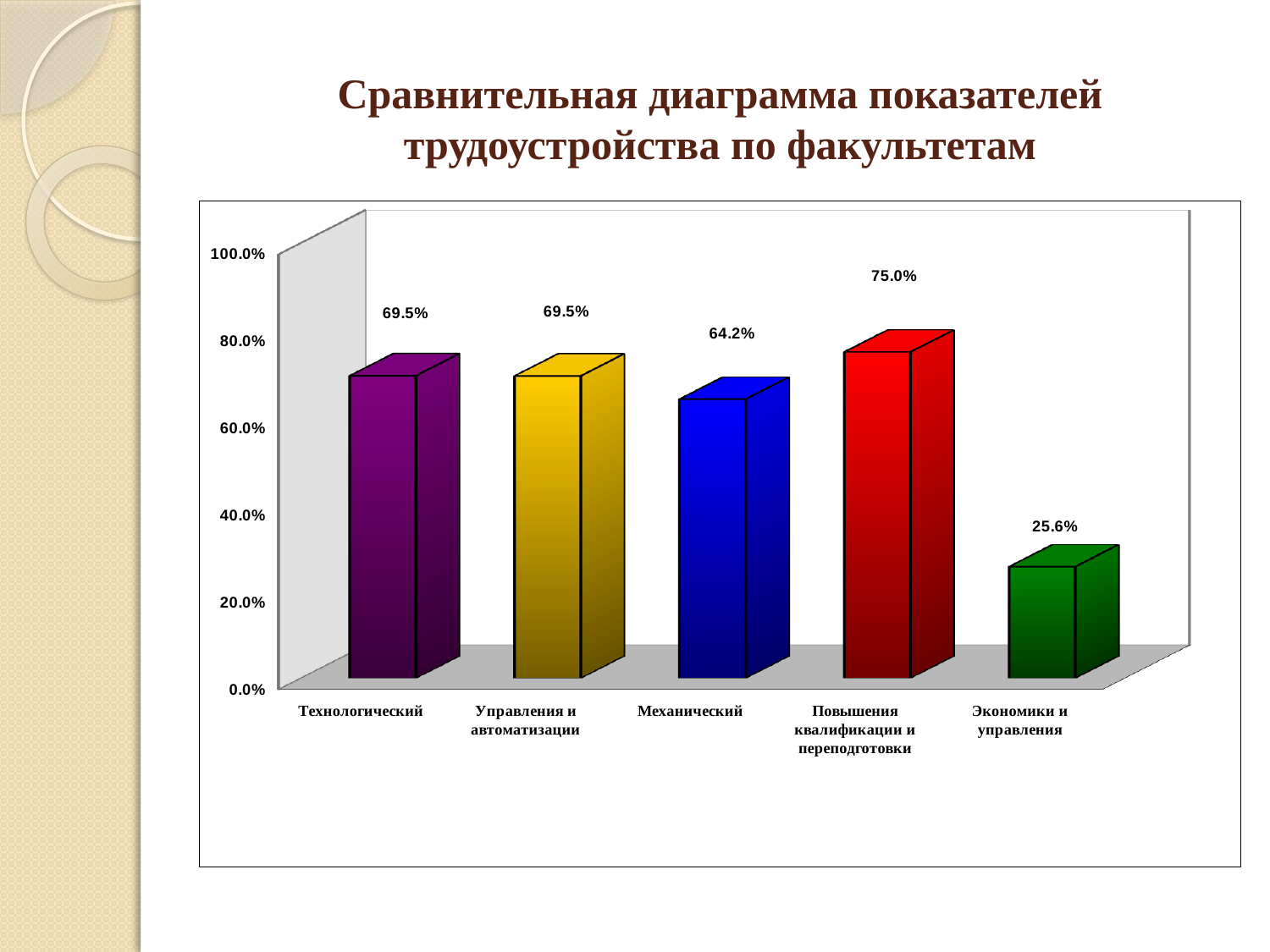
What is the difference between the values for Повышения квалификации и переподготовки and Экономики и управления? 49.4% What is the value shown for Повышения квалификации и переподготовки? 75.0% What is the difference between the values for Технологический and Механический? 5.3% What is the employment rate for the Технологический faculty? 69.5% What colour is the bar for Управления и автоматизации? Yellow What is the value shown for Механический? 64.2% Which faculty has the lowest employment rate? Экономики и управления Which is larger: the value for Механический or the value for Повышения квалификации и переподготовки? Повышения квалификации и переподготовки Which faculty has the highest employment rate? Повышения квалификации и переподготовки What type of chart is shown on the slide? Bar chart How many faculties are shown in the chart? 5 What is the value shown for Экономики и управления? 25.6%